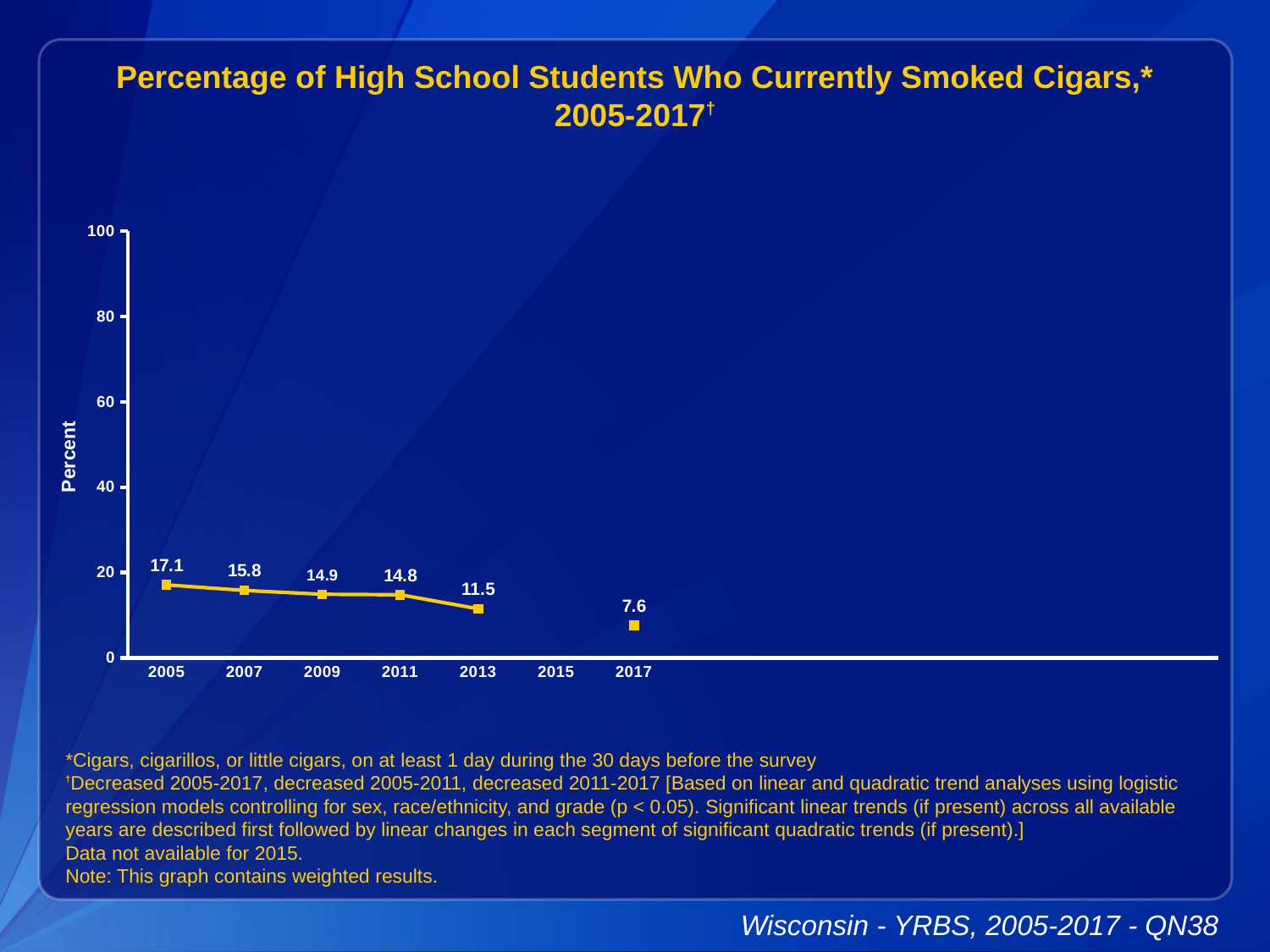
What was the percentage of high school students who currently smoked cigars in 2005? 17.1 How many years have a plotted data point on the chart? 6 Which year has the highest percentage of students who currently smoked cigars? 2005 What is the difference between the 2005 value and the 2017 value? 9.5 Which year has the lowest percentage of students who currently smoked cigars? 2017 What was the percentage of high school students who currently smoked cigars in 2017? 7.6 What value is plotted for 2011? 14.8 Do the values rise or fall from 2005 to 2017? fall What is the label on the vertical axis? Percent What kind of chart is shown on the slide? line chart Which year has a larger value, 2009 or 2013? 2009 Is the value for 2013 greater or less than 20? less